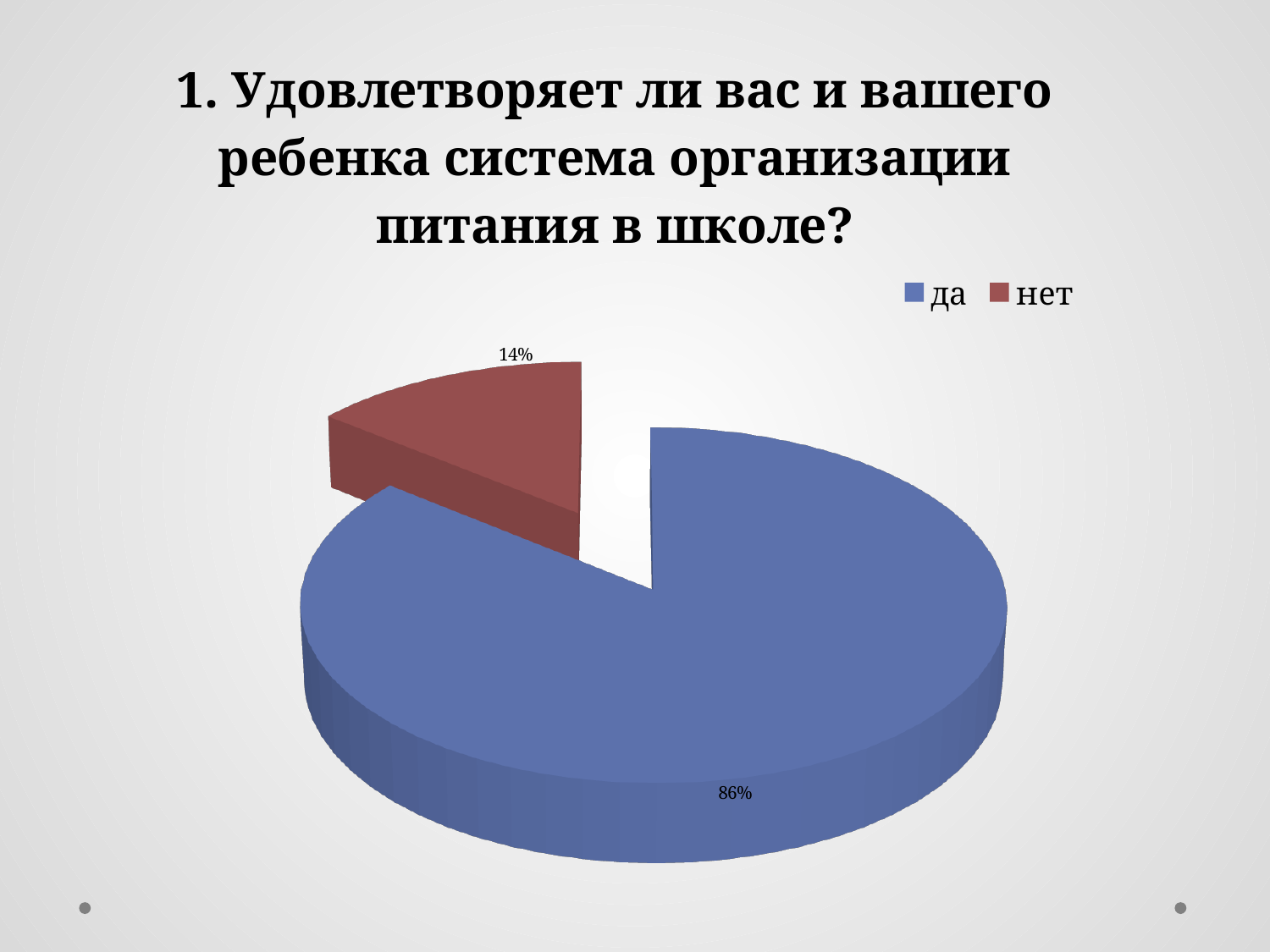
What colour is the "нет" slice? red Which category has the smallest slice of the pie? нет Which is larger, the "да" slice or the "нет" slice? да How many slices does the pie chart have? 2 What colour is the "да" slice? blue How many entries does the legend list? 2 What is the difference in percentage points between the "да" and "нет" slices? 72 What share of the pie does the "да" slice represent? 86% What kind of chart is shown on the slide? pie chart Which category has the largest slice of the pie? да What share of the pie does the "нет" slice represent? 14%